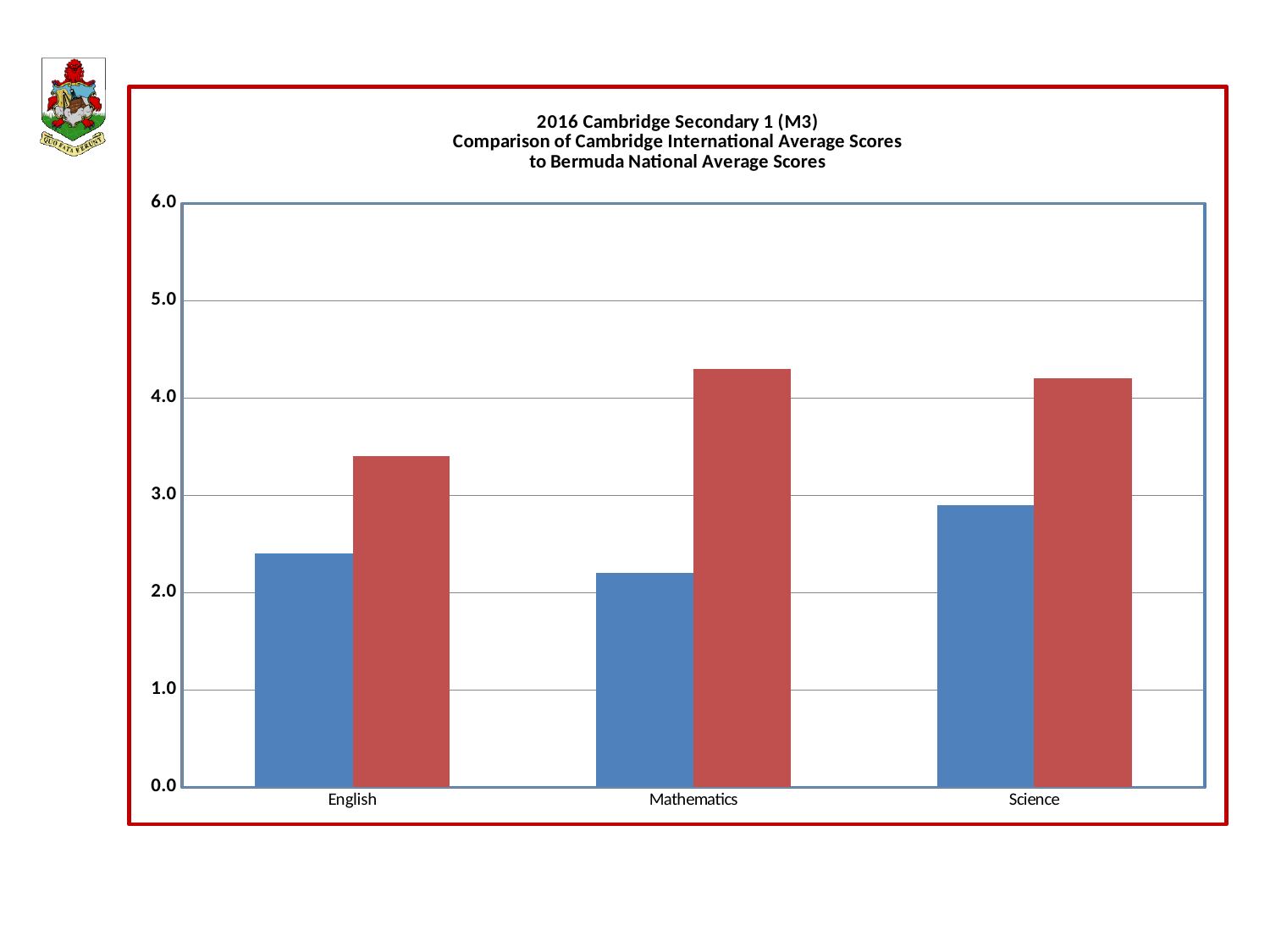
How many subject categories are shown on the x axis? 3 Among the red bars, which subject has the lowest value? English Is the value of the red bar for Science greater or less than 5.0? less Among the blue bars, which subject has the highest value? Science Is the value of the red bar for Mathematics greater or less than 4.0? greater What is the title of the chart? 2016 Cambridge Secondary 1 (M3) Comparison of Cambridge International Average Scores to Bermuda National Average Scores What kind of chart is shown on the slide? bar chart For Mathematics, which bar is larger, the blue bar or the red bar? the red bar Is the value of the red bar for English greater or less than 4.0? less How many bars are shown for each subject category? 2